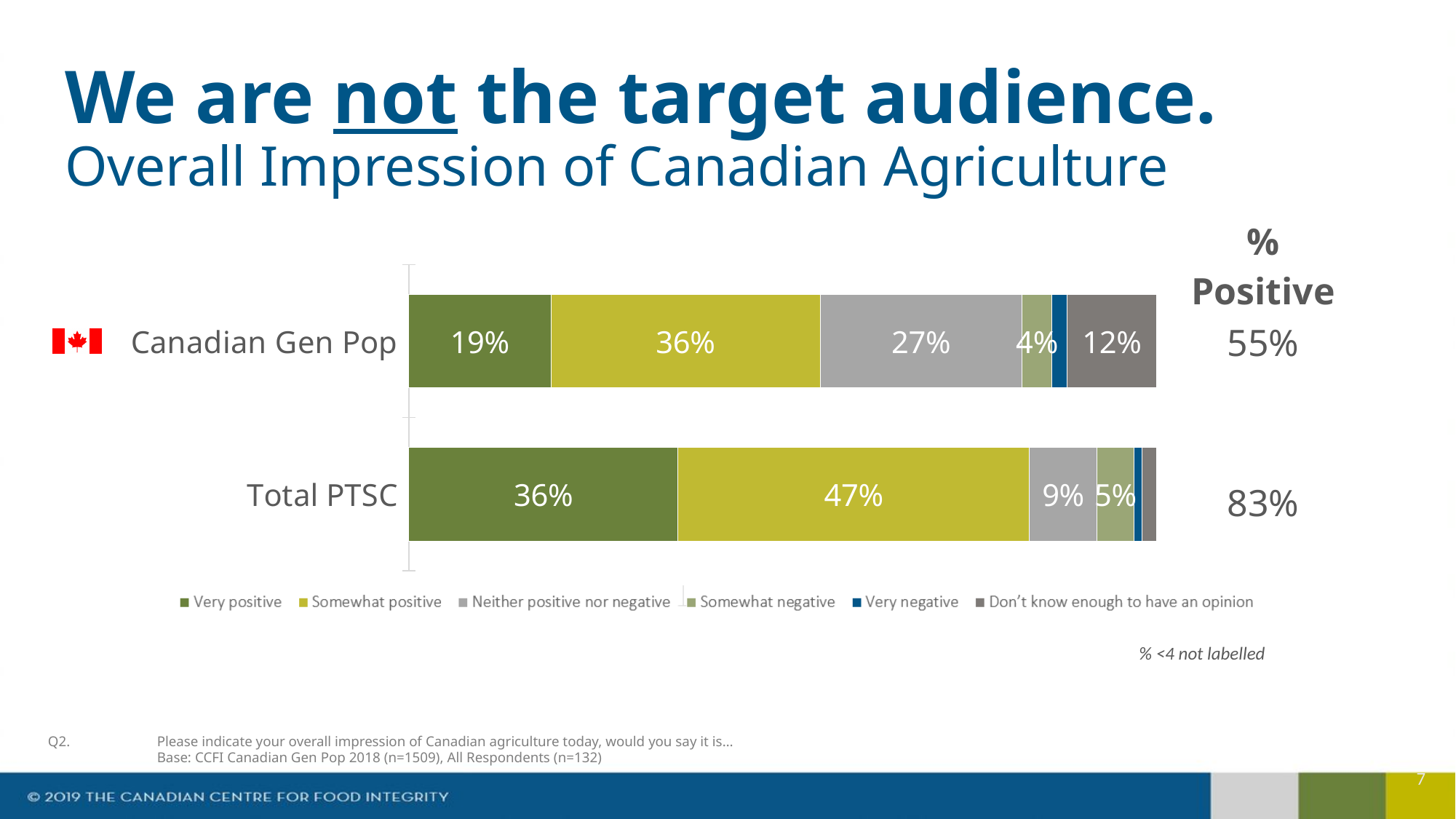
What is the Neither positive nor negative value for Canadian Gen Pop? 27% What is the Somewhat positive value for Total PTSC? 47% How many series does the legend list? 6 How many categories (bars) does the chart show? 2 Which legend entry is shown in dark blue? Very negative What is the Don't know enough to have an opinion value for Canadian Gen Pop? 12% Which category has the higher Very positive value, Canadian Gen Pop or Total PTSC? Total PTSC What is the difference in % Positive between Total PTSC and Canadian Gen Pop? 28% What kind of chart is shown on the slide? bar chart What is the difference between the Somewhat positive values for Total PTSC and Canadian Gen Pop? 11% What is the % Positive figure shown for Total PTSC? 83% What is the Very positive value for Canadian Gen Pop? 19%